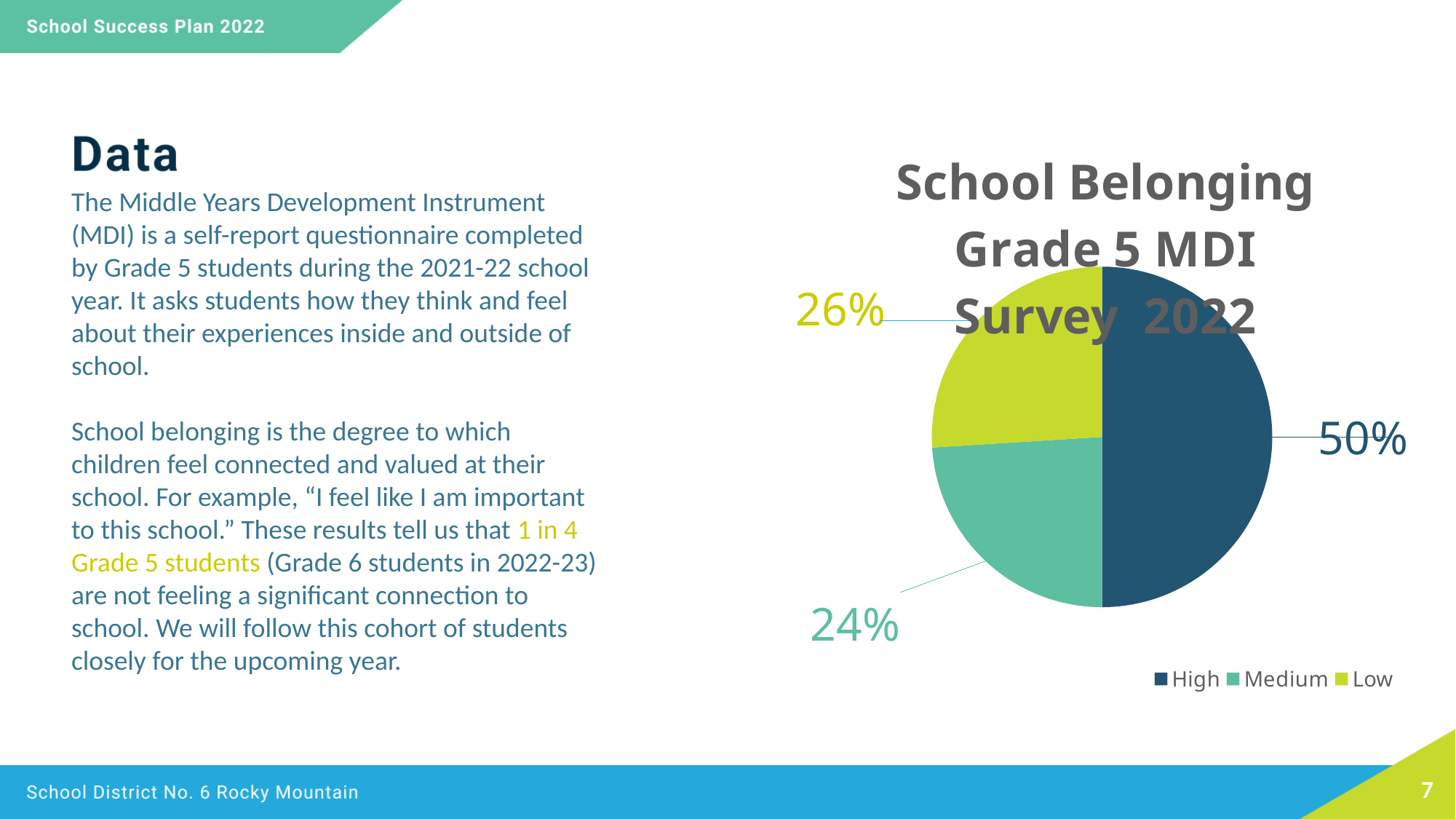
What is the title of the chart? School Belonging Grade 5 MDI Survey 2022 Which is larger, the High share or the Medium share? High Which category has the smallest share of the pie? Medium What percentage of the pie is labelled Low? 26% What percentage of the pie is labelled High? 50% How many categories does the legend list? 3 Which category has the largest share of the pie? High What colour is the Low slice in the pie chart? Yellow-green What is the difference between the Low and Medium shares? 2% What kind of chart is shown on the slide? Pie chart What percentage of the pie is labelled Medium? 24% What is the difference between the High and Low shares? 24%